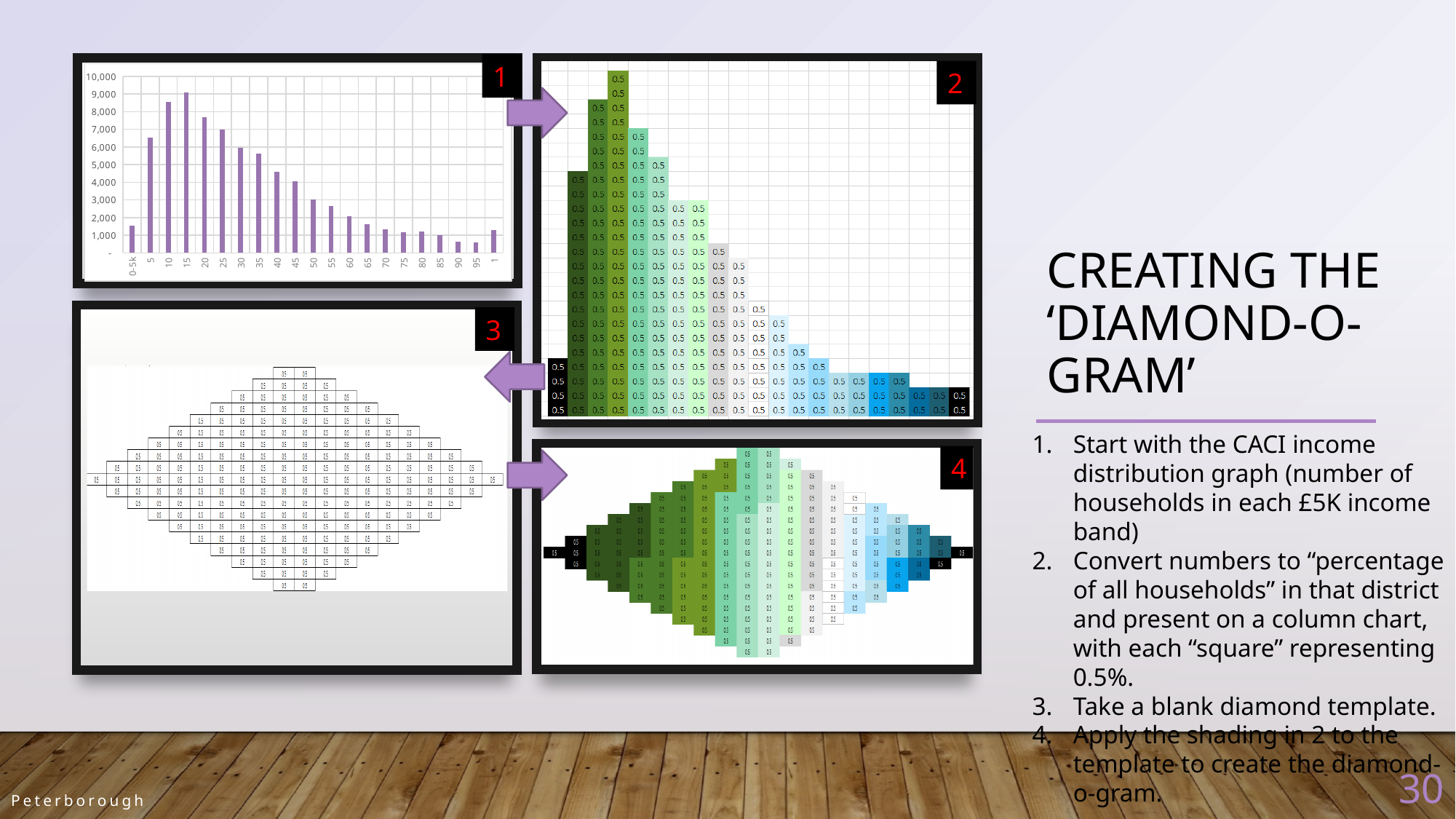
In the panel 2 chart (top right), what value is printed in each square? 0.5 What kind of chart is shown in panel 1 (top left)? bar chart In the panel 1 chart (top left), how many bars are plotted along the x axis? 21 In the panel 1 chart (top left), which bar is taller, 10 or 20? 10 In the panel 1 chart (top left), is the value for the 0-5k band greater or less than 2,000? less In the panel 1 chart (top left), is the value for the 15 band greater or less than 8,000? greater In the panel 1 chart (top left), is the value for the 40 band greater or less than 4,000? greater In the panel 1 chart (top left), which income band has the highest bar? 15 In the panel 1 chart (top left), what is the highest value shown on the y axis? 10,000 In the panel 1 chart (top left), do the bars rise or fall from the 15 band to the 95 band? fall In the panel 1 chart (top left), which bar is taller, 25 or 30? 25